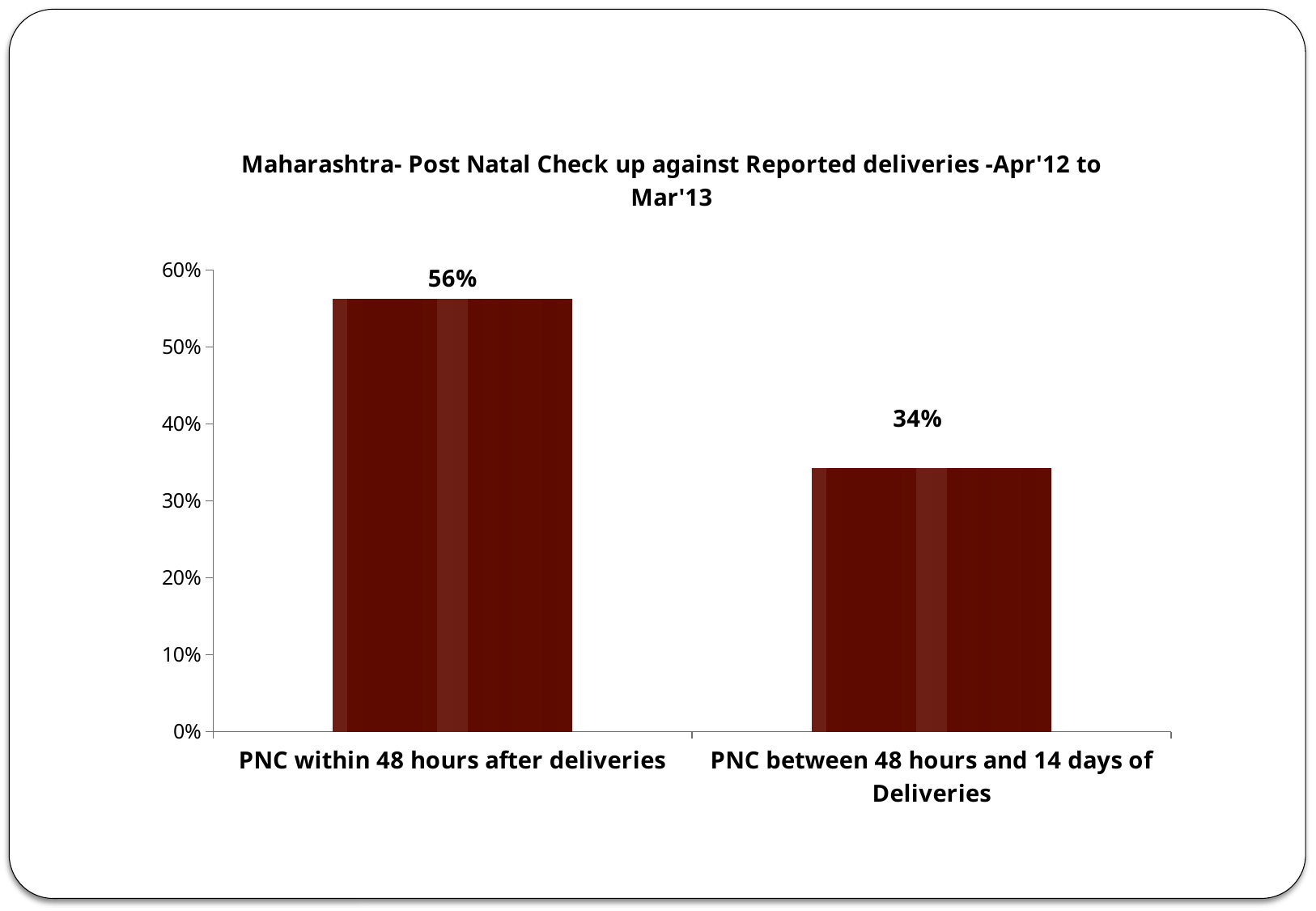
What is the value for PNC within 48 hours after deliveries? 56% How many categories are shown on the chart? 2 What is the title of the chart? Maharashtra- Post Natal Check up against Reported deliveries -Apr'12 to Mar'13 Which category has the highest value? PNC within 48 hours after deliveries What is the difference between the value for PNC within 48 hours after deliveries and the value for PNC between 48 hours and 14 days of Deliveries? 22% Is the value for PNC within 48 hours after deliveries greater or less than 50%? greater Which is larger: the value for PNC within 48 hours after deliveries or the value for PNC between 48 hours and 14 days of Deliveries? PNC within 48 hours after deliveries What is the highest value shown on the vertical axis? 60% What kind of chart is shown on the slide? bar chart Which category has the lowest value? PNC between 48 hours and 14 days of Deliveries Is the value for PNC between 48 hours and 14 days of Deliveries greater or less than 40%? less What is the value for PNC between 48 hours and 14 days of Deliveries? 34%